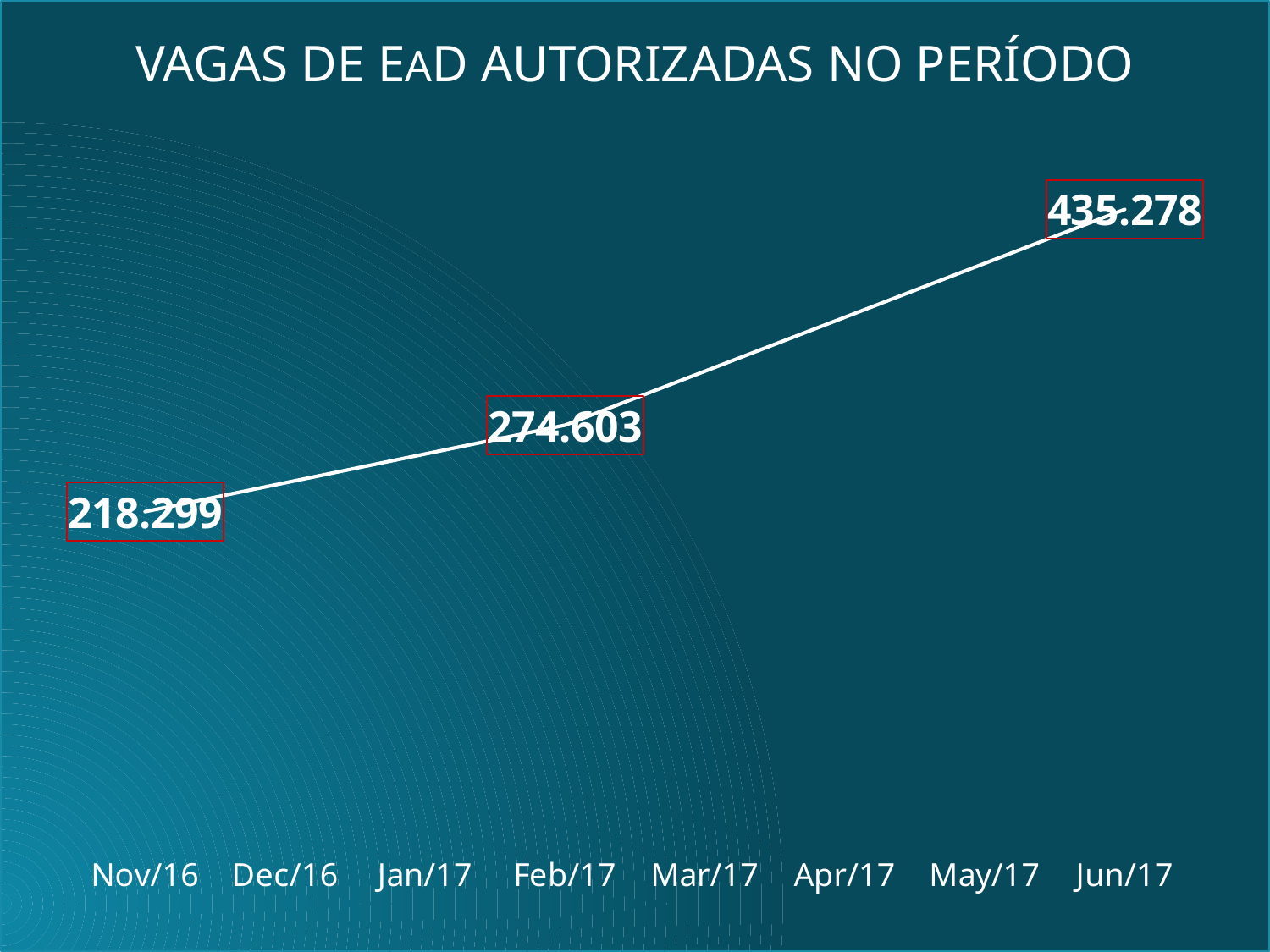
Do the values rise or fall from left to right along the x axis? rise What is the difference between the last value (435.278) and the first value (218.299)? 216.979 Which data point has the highest value? 435.278 (the last point, Jun/17) What kind of chart is shown on the slide? line chart What is the value of the middle data point on the line? 274.603 What value is shown for Jun/17? 435.278 What is the value of the last (rightmost) data point on the line? 435.278 What is the title of the chart? VAGAS DE EaD AUTORIZADAS NO PERÍODO Which data point has the lowest value? 218.299 (the first point, Nov/16) How many data labels are shown on the line? 3 What is the value of the first (leftmost) data point on the line? 218.299 What is the difference between the middle value (274.603) and the first value (218.299)? 56.304